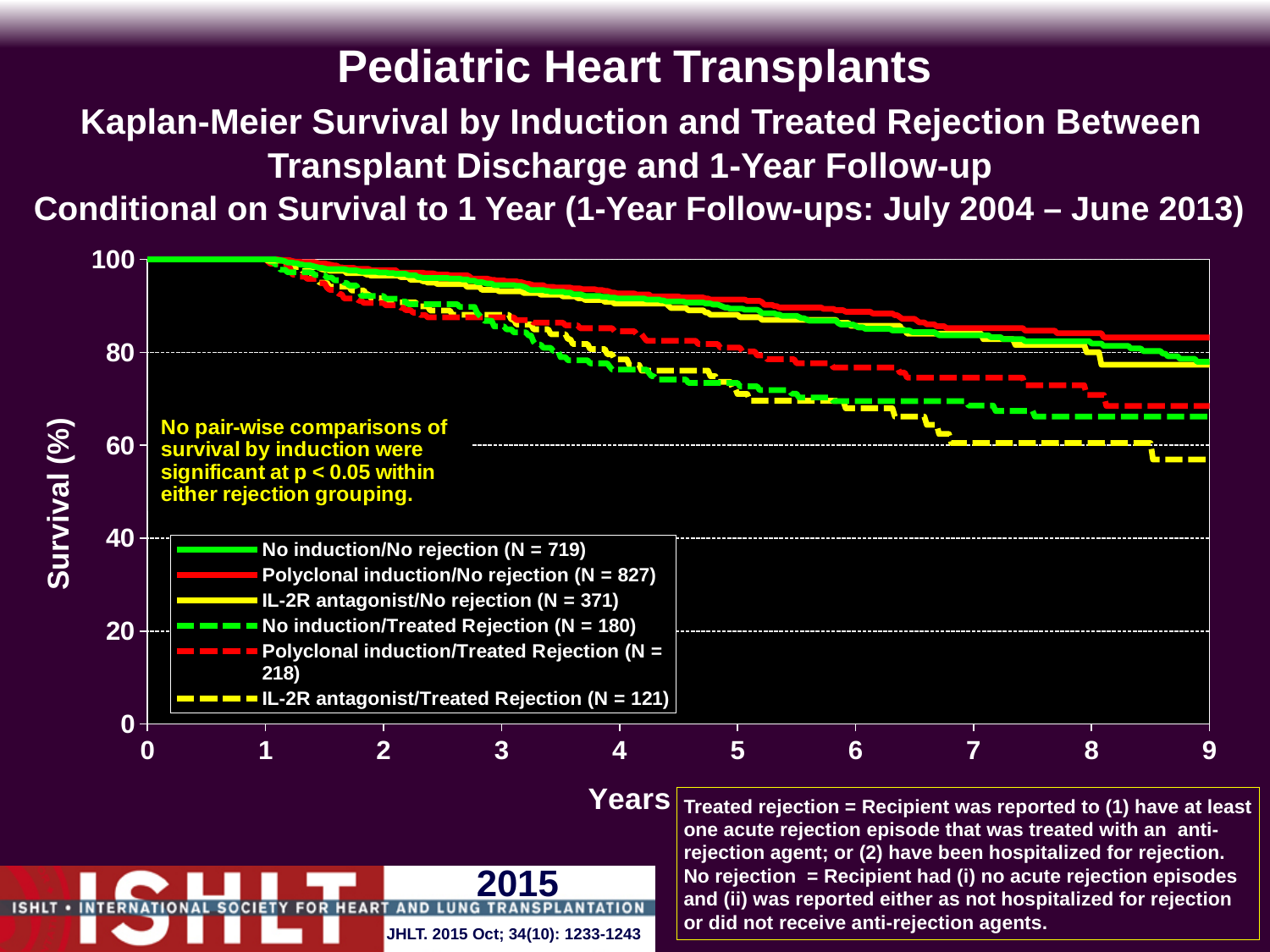
What is the label of the x axis? Years Is the value for No induction/Treated Rejection at 9 years greater or less than 60? greater Do the survival curves rise or fall as years increase? Fall Is the value for IL-2R antagonist/Treated Rejection at 9 years greater or less than 60? less According to the legend, what is N for the No induction/No rejection group? 719 Is the value for Polyclonal induction/No rejection at 9 years greater or less than 80? greater How many series does the legend list? 6 What kind of chart is shown on the slide? Line chart At 9 years, which series has the highest survival? Polyclonal induction/No rejection What is the label of the y axis? Survival (%) At 9 years, which series has the lowest survival? IL-2R antagonist/Treated Rejection At 9 years, which is larger: the survival for Polyclonal induction/No rejection or for IL-2R antagonist/Treated Rejection? Polyclonal induction/No rejection